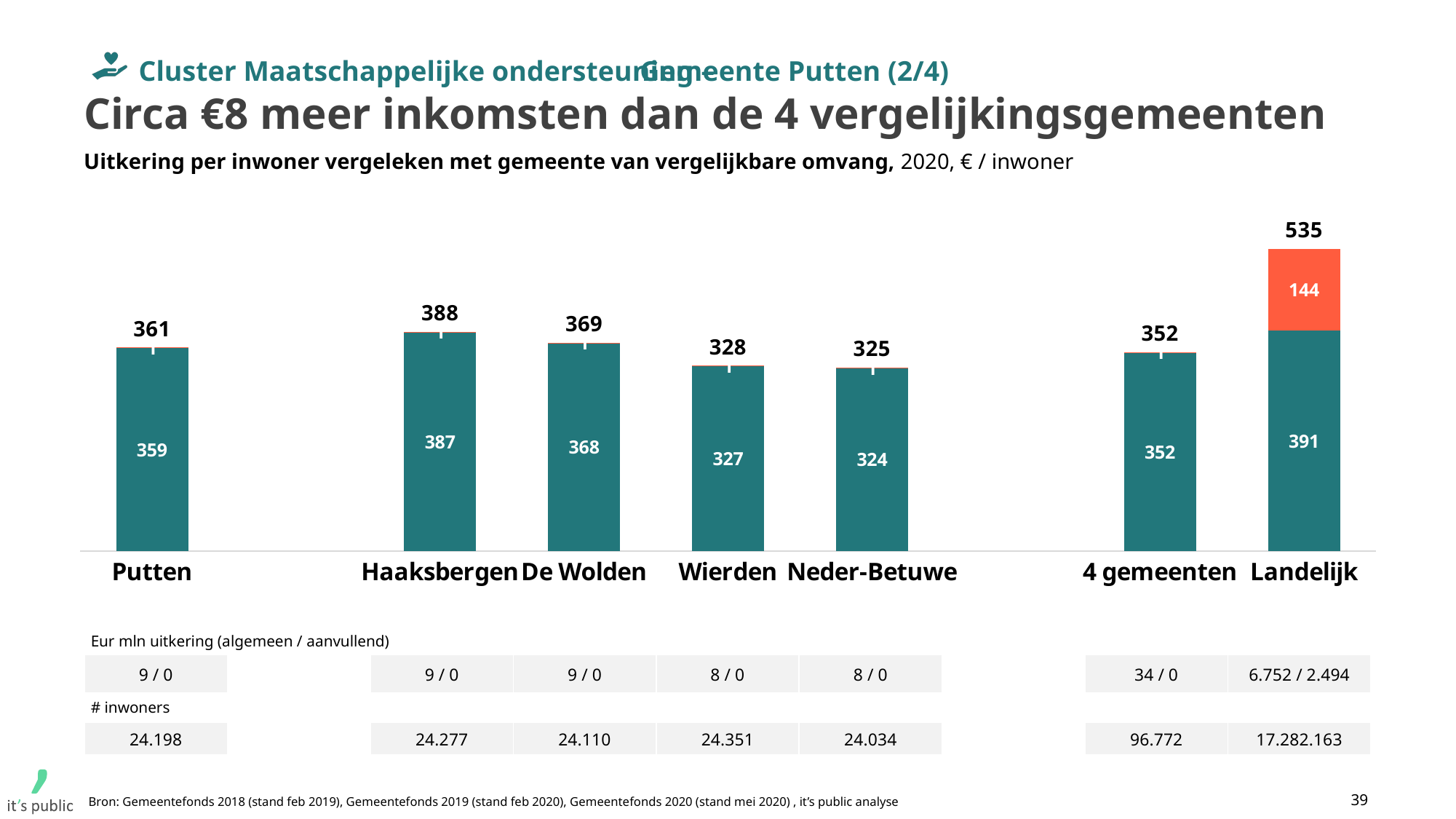
Which category has the highest total value? Landelijk What is the value of the teal (bottom) segment of the Haaksbergen bar? 387 How many categories are shown on the x axis of the chart? 7 What is the difference between the total for Haaksbergen and the total for De Wolden? 19 What kind of chart is shown on the slide? Stacked bar chart Which has a larger total value, Wierden or De Wolden? De Wolden What is the value of the orange (top) segment of the Landelijk bar? 144 Which category has the lowest total value? Neder-Betuwe What is the value of the teal (bottom) segment of the Landelijk bar? 391 What is the total value shown above the bar for Landelijk? 535 What is the difference between the total for Putten and the total for 4 gemeenten? 9 What is the total value shown above the bar for Putten? 361